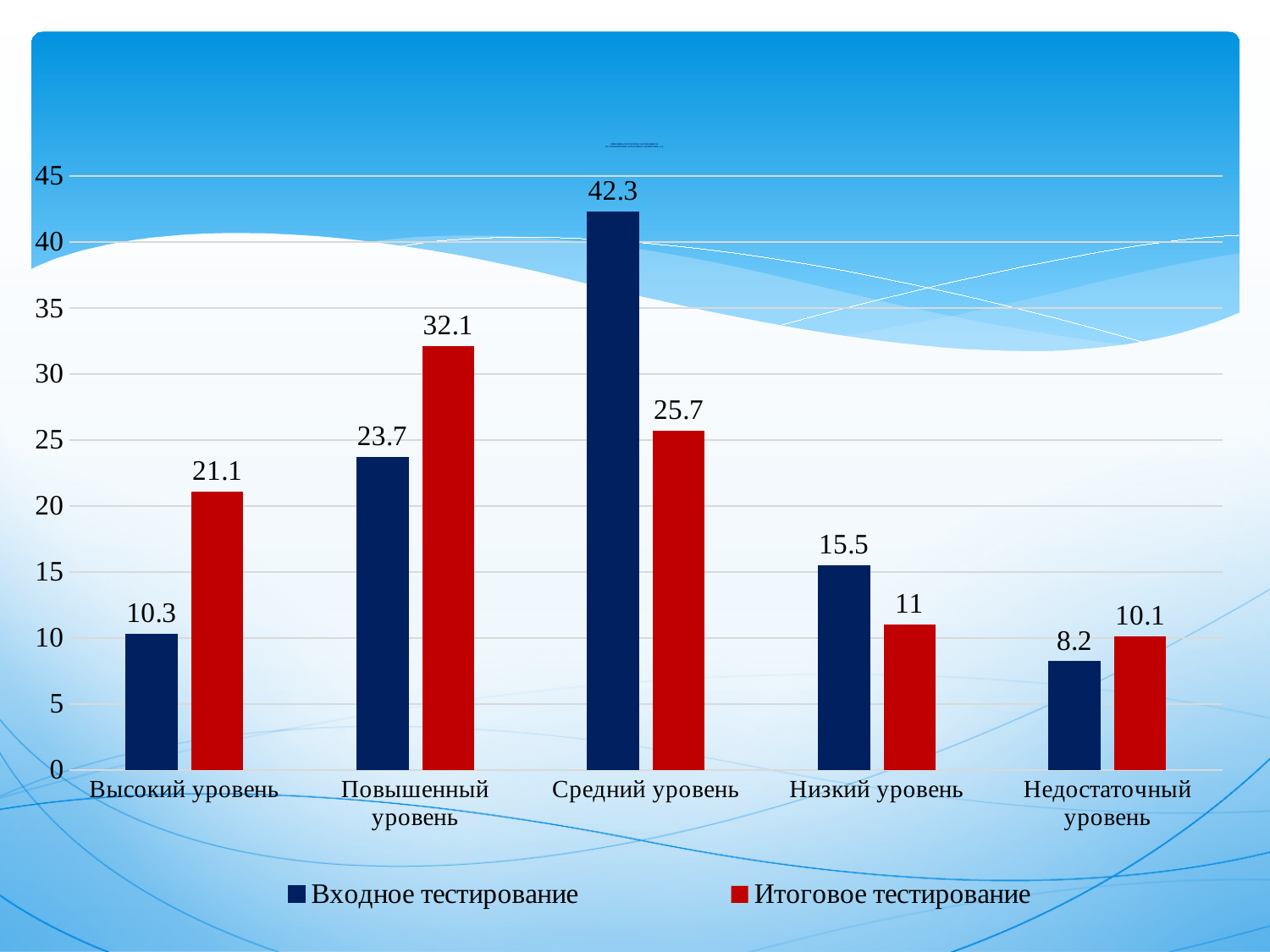
How many series does the legend list? 2 How many categories are shown on the x axis? 5 What is the difference between Входное тестирование and Итоговое тестирование at Средний уровень? 16.6 What is the value for Итоговое тестирование at Низкий уровень? 11 What is the value for Входное тестирование at Средний уровень? 42.3 Which is larger at Повышенный уровень: Входное тестирование or Итоговое тестирование? Итоговое тестирование What kind of chart is shown on the slide? Bar chart Which category has the highest value for Входное тестирование? Средний уровень What colour are the bars for Итоговое тестирование? Red Which category has the lowest value for Итоговое тестирование? Недостаточный уровень What is the value for Итоговое тестирование at Высокий уровень? 21.1 What is the difference between Итоговое тестирование and Входное тестирование at Высокий уровень? 10.8